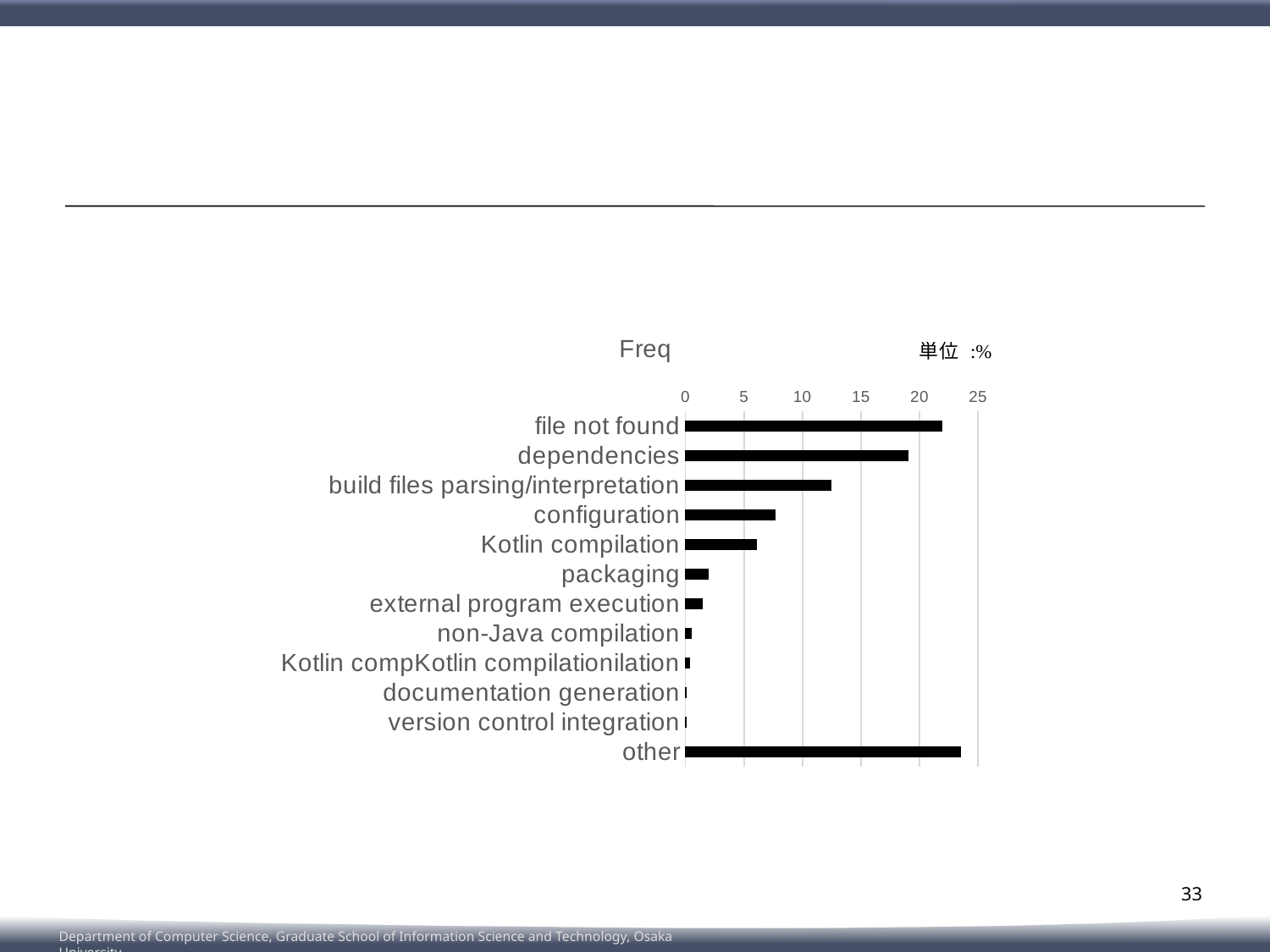
Is the value for dependencies greater or less than 15? greater What is the title of the chart? Freq Is the value for file not found greater or less than 20? greater Which has the larger value, file not found or dependencies? file not found Which has the larger value, build files parsing/interpretation or configuration? build files parsing/interpretation Is the value for configuration greater or less than 10? less What kind of chart is shown on the slide? bar chart How many categories are plotted in the chart? 12 Which has the larger value, packaging or Kotlin compilation? Kotlin compilation